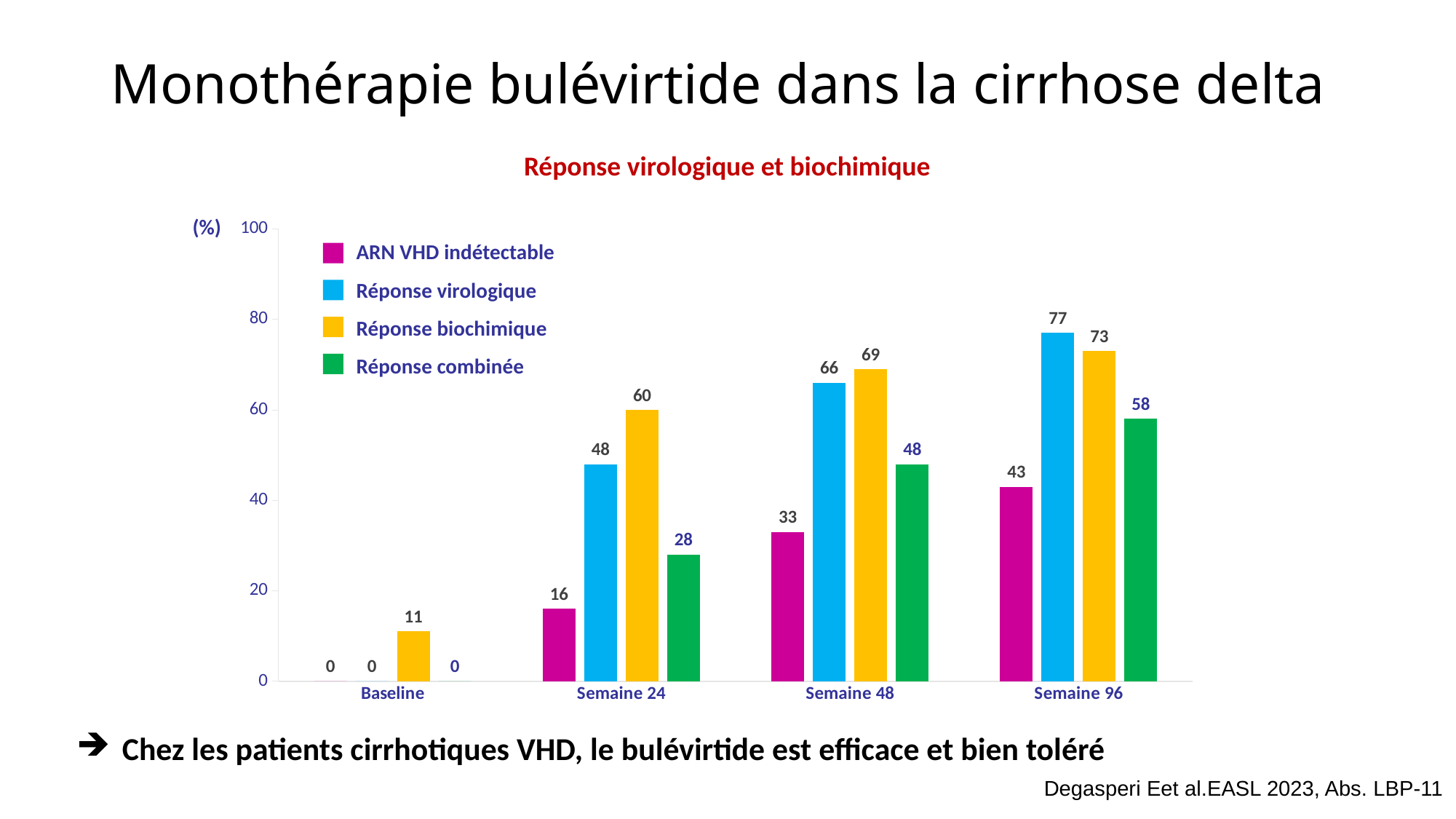
What is the value for Réponse biochimique at Baseline? 11 What kind of chart is shown on the slide? Bar chart How many time points are shown on the x axis? 4 How many series does the legend list? 4 What is the value for Réponse virologique at Semaine 96? 77 Which is larger at Semaine 48: Réponse virologique or Réponse biochimique? Réponse biochimique At which time point is Réponse combinée highest? Semaine 96 Which series has the lowest value at Semaine 24? ARN VHD indétectable What is the value for ARN VHD indétectable at Semaine 48? 33 What is the value for Réponse combinée at Semaine 24? 28 What is the difference between Réponse biochimique and Réponse virologique at Semaine 24? 12 Does the value for ARN VHD indétectable rise or fall from Baseline to Semaine 96? Rise